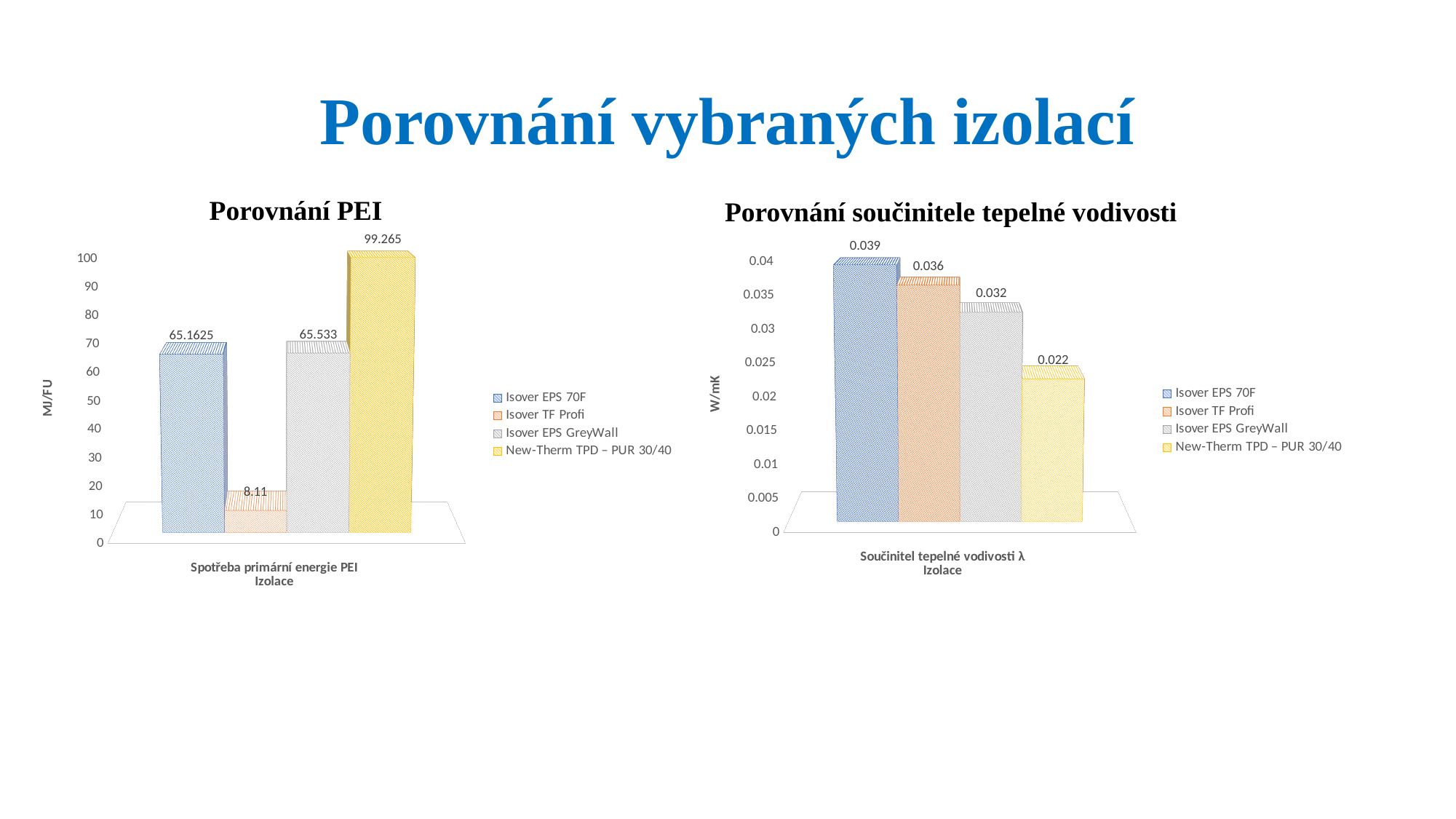
What kind of chart is the 'Porovnání součinitele tepelné vodivosti' chart? Bar chart In the 'Porovnání součinitele tepelné vodivosti' chart, what is the value for Isover EPS GreyWall? 0.032 In the 'Porovnání PEI' chart, what is the difference between the values for New-Therm TPD – PUR 30/40 and Isover EPS GreyWall? 33.732 In the 'Porovnání součinitele tepelné vodivosti' chart, which is larger: the value for Isover TF Profi or the value for New-Therm TPD – PUR 30/40? Isover TF Profi In the 'Porovnání PEI' chart, which series has the highest value? New-Therm TPD – PUR 30/40 In the 'Porovnání PEI' chart, what is the value for New-Therm TPD – PUR 30/40? 99.265 How many series does the legend of the 'Porovnání PEI' chart list? 4 What is the vertical axis label of the 'Porovnání součinitele tepelné vodivosti' chart? W/mK In the 'Porovnání součinitele tepelné vodivosti' chart, which series has the highest value? Isover EPS 70F In the 'Porovnání PEI' chart, what is the value for Isover TF Profi? 8.11 In the 'Porovnání PEI' chart, which series has the lowest value? Isover TF Profi In the 'Porovnání součinitele tepelné vodivosti' chart, what is the difference between the values for Isover EPS 70F and New-Therm TPD – PUR 30/40? 0.017